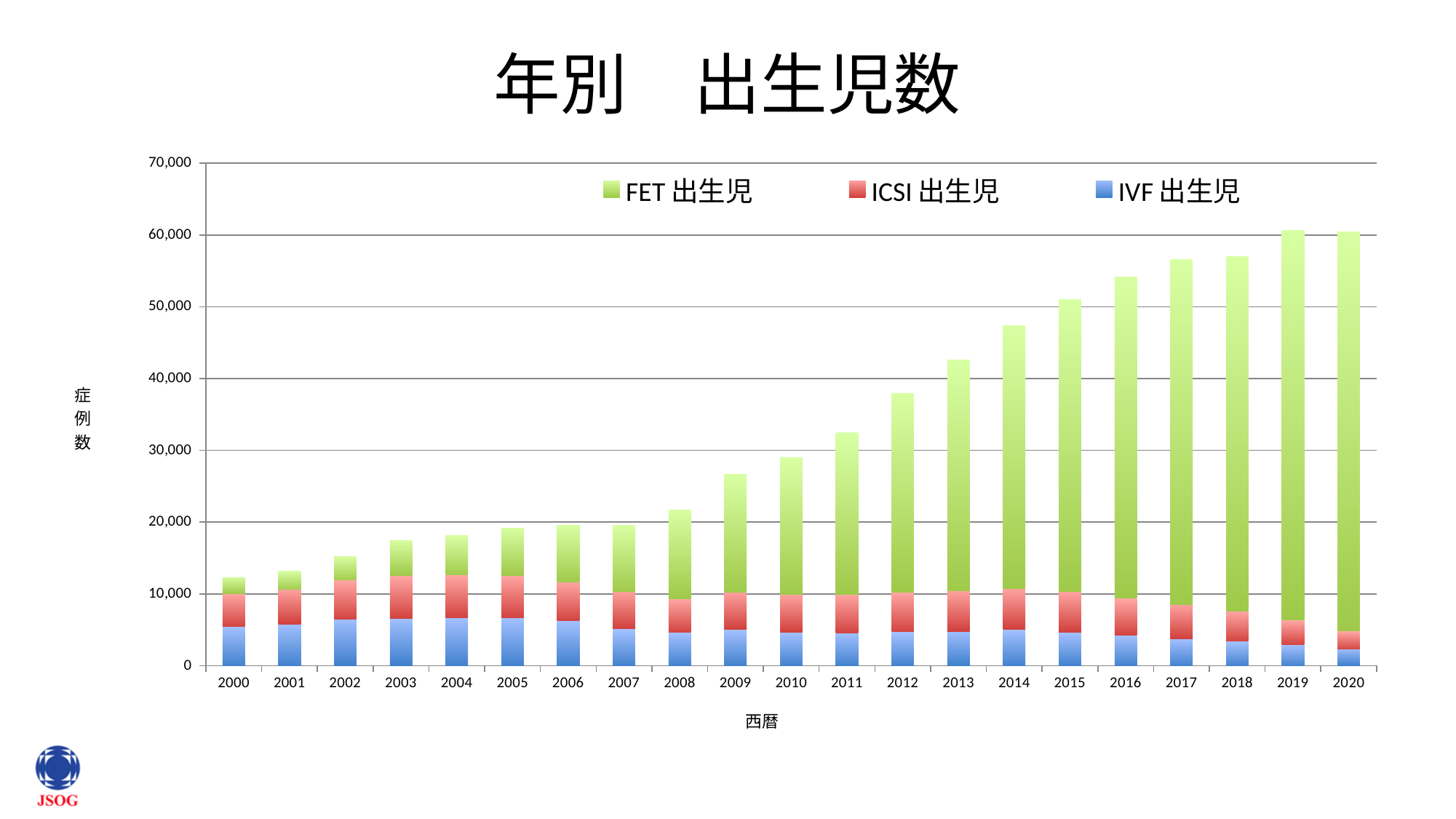
What is the title of the chart on the slide? 年別 出生児数 Which year has the larger total number of births, 2012 or 2014? 2014 How many series does the chart's legend list? 3 What kind of chart is shown on the slide? Stacked bar chart Is the total value for 2000 greater or less than 10,000? greater Is the total value for 2016 greater or less than 50,000? greater How many years are shown along the x axis of the chart? 21 Which year has the lowest total number of births in the chart? 2000 Is the total value for 2010 greater or less than 30,000? less Which colour represents the FET 出生児 series in the chart? Green Do the total births generally rise or fall from 2000 to 2020? Rise